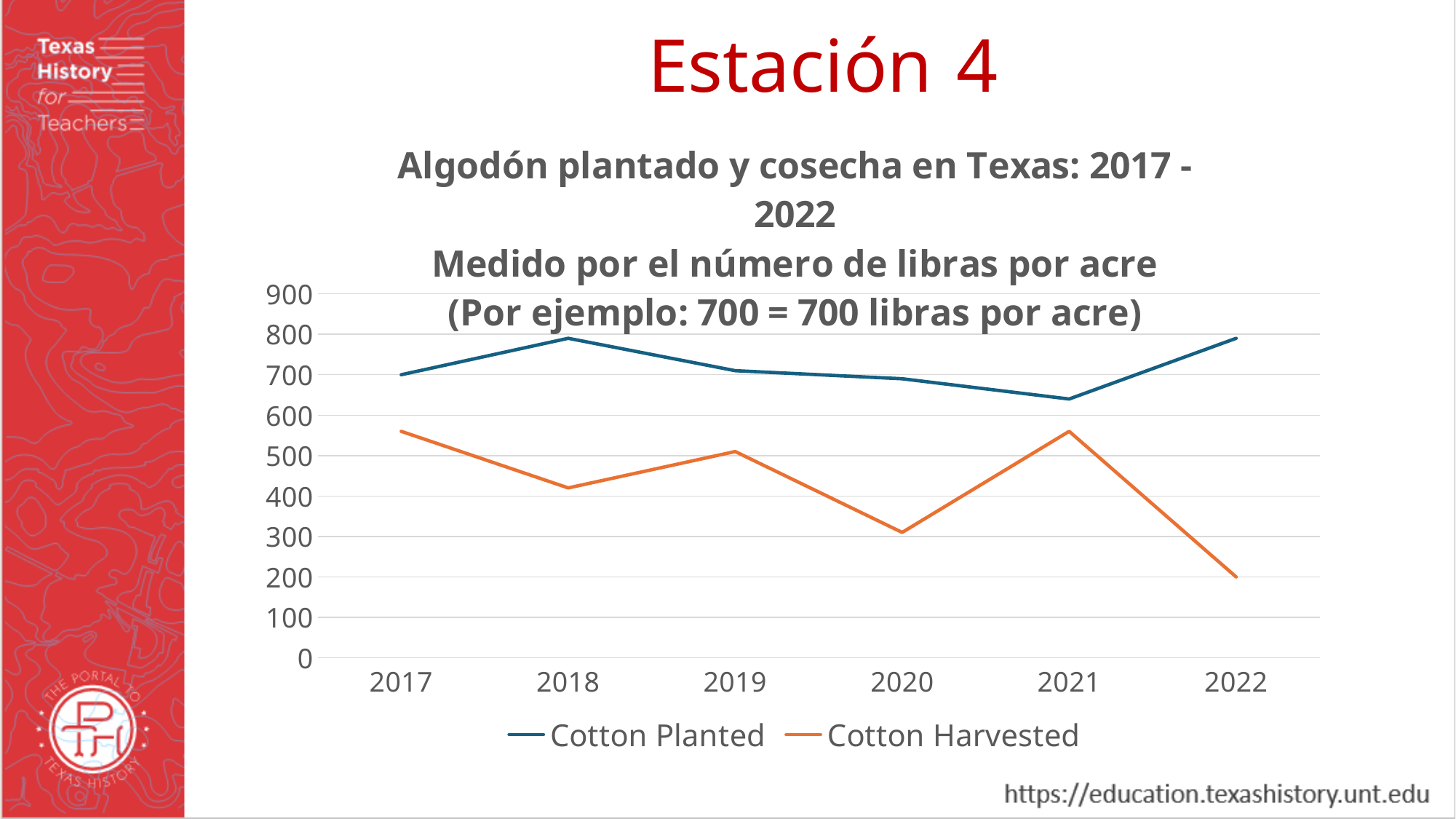
Is the value for Cotton Harvested in 2020 greater or less than 400? less Does Cotton Harvested rise or fall from 2021 to 2022? fall Is the value for Cotton Harvested in 2021 greater or less than 500? greater In which year is Cotton Harvested lowest? 2022 Is the value for Cotton Planted in 2021 greater or less than 700? less What kind of chart is shown on the slide? line chart In 2020, which is larger: Cotton Planted or Cotton Harvested? Cotton Planted How many series does the legend list? 2 What is the value for Cotton Planted in 2017? 700 How many years are plotted along the x axis? 6 What is the value for Cotton Harvested in 2022? 200 In which year is Cotton Planted lowest? 2021